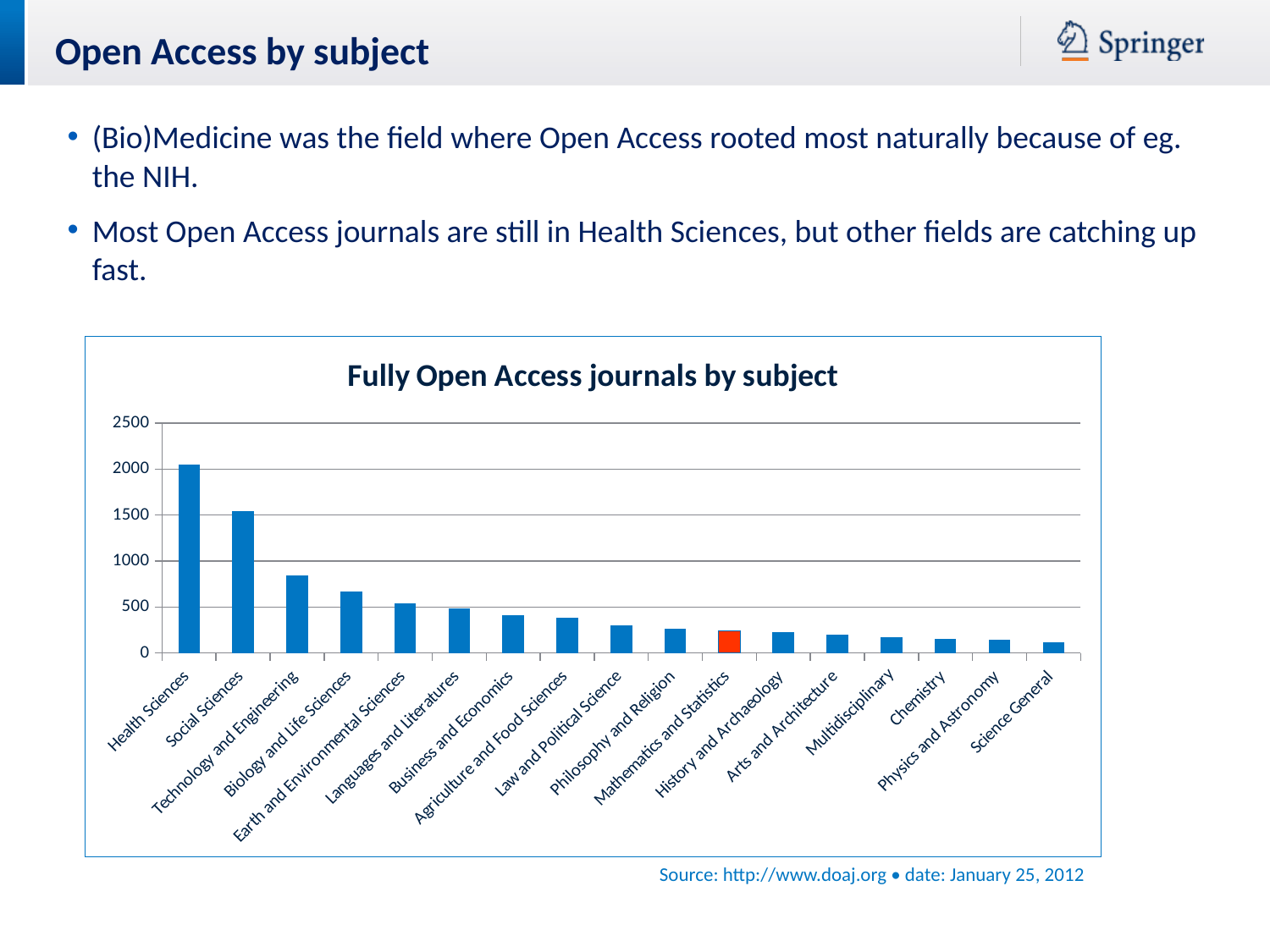
Is the value for Technology and Engineering greater or less than 1000? less What kind of chart is shown on the slide? bar chart How many subject categories are shown in the chart? 17 Which subject's bar is highlighted in red rather than blue? Mathematics and Statistics Which has more fully Open Access journals, Social Sciences or Technology and Engineering? Social Sciences Is the value for Health Sciences greater or less than 2000? greater Do the values rise or fall moving from left to right along the x axis? fall Which subject has the lowest number of fully Open Access journals? Science General Which subject has the highest number of fully Open Access journals? Health Sciences What is the title of the chart? Fully Open Access journals by subject Is the value for Biology and Life Sciences greater or less than 500? greater